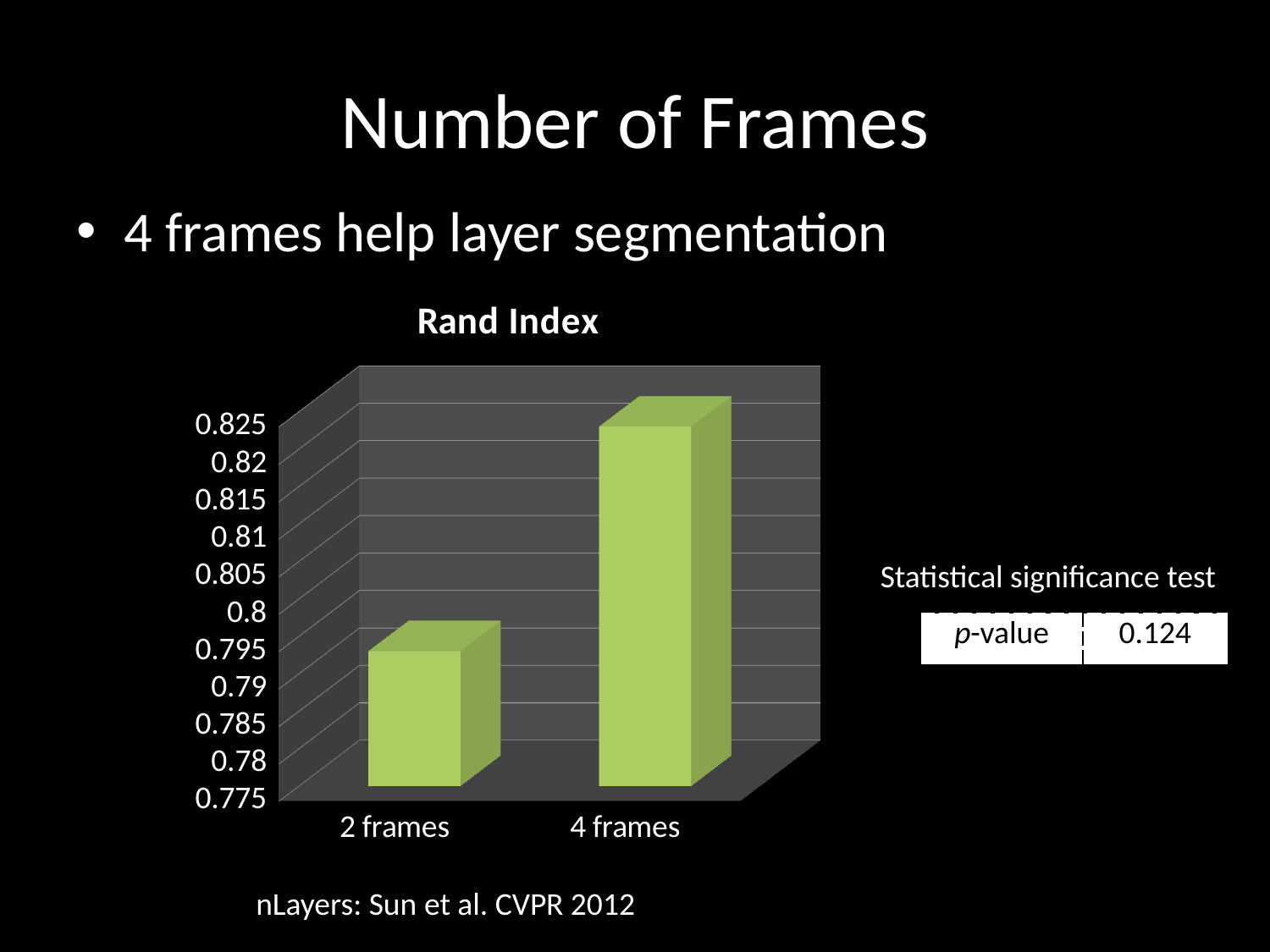
Is the value for 2 frames greater or less than 0.81? less What is the title of the chart? Rand Index Is the value for 4 frames greater or less than 0.81? greater How many categories are plotted in the chart? 2 Which category has the lowest Rand Index? 2 frames Do the values rise or fall from 2 frames to 4 frames? rise Is the value for 4 frames greater or less than 0.8? greater Which is larger, the Rand Index for 2 frames or for 4 frames? 4 frames What kind of chart is shown on the slide? bar chart What is the lowest value shown on the vertical axis of the chart? 0.775 Which category has the highest Rand Index? 4 frames